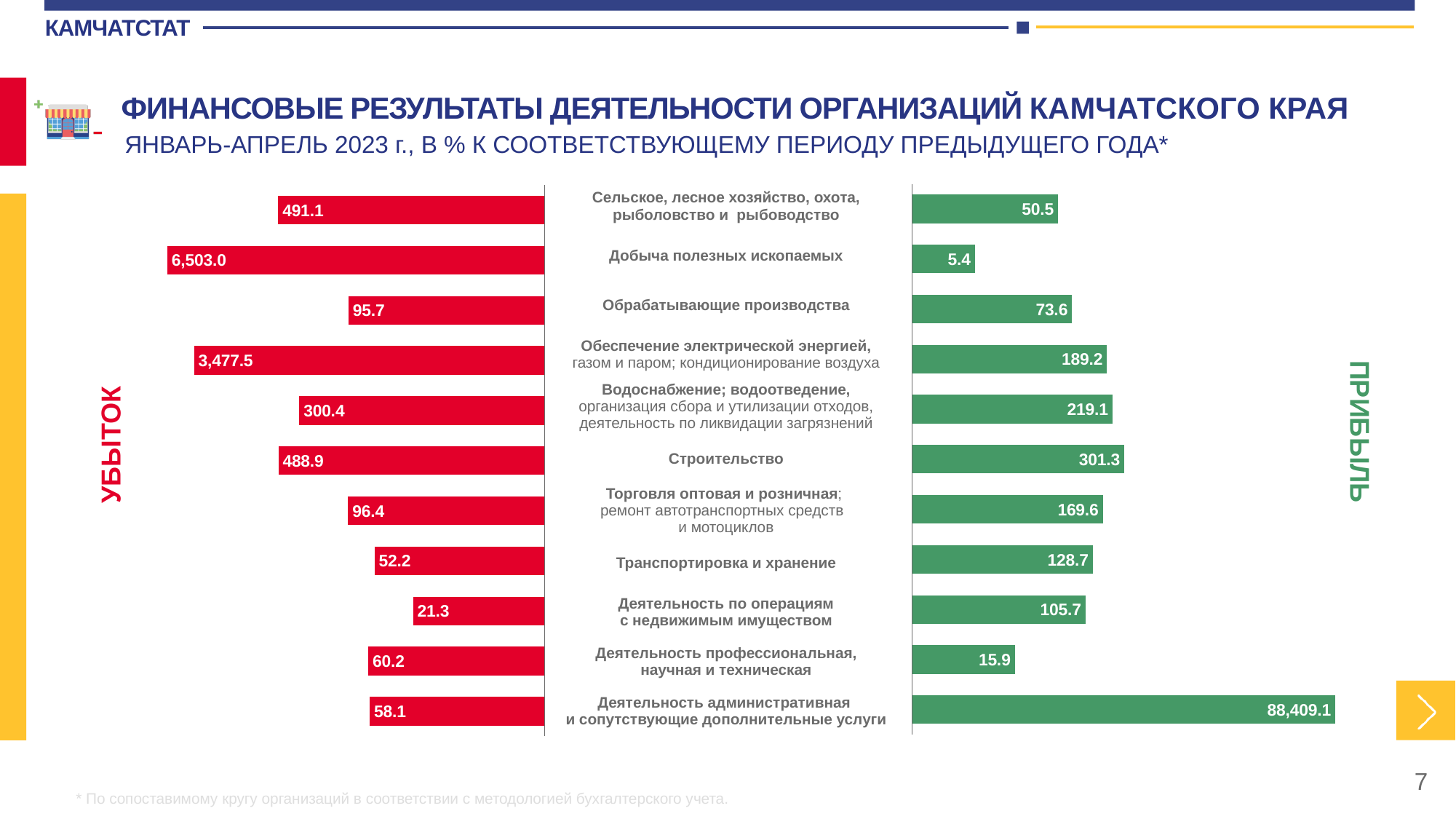
What colour are the УБЫТОК (loss) bars? Red What is the ПРИБЫЛЬ (profit) value for Строительство? 301.3 Which category has the lowest УБЫТОК (loss) value? Деятельность по операциям с недвижимым имуществом Which category has the highest УБЫТОК (loss) value? Добыча полезных ископаемых Which category has the lowest ПРИБЫЛЬ (profit) value? Добыча полезных ископаемых What is the ПРИБЫЛЬ (profit) value for Деятельность административная и сопутствующие дополнительные услуги? 88,409.1 What is the difference between the УБЫТОК (loss) and ПРИБЫЛЬ (profit) values for Строительство? 187.6 How many categories (industries) are shown in the chart? 11 What is the УБЫТОК (loss) value for Обеспечение электрической энергией, газом и паром; кондиционирование воздуха? 3,477.5 What kind of chart is shown on the slide? Bar chart What is the УБЫТОК (loss) value for Добыча полезных ископаемых? 6,503.0 For Транспортировка и хранение, which is larger: the УБЫТОК (loss) value or the ПРИБЫЛЬ (profit) value? ПРИБЫЛЬ (profit), 128.7